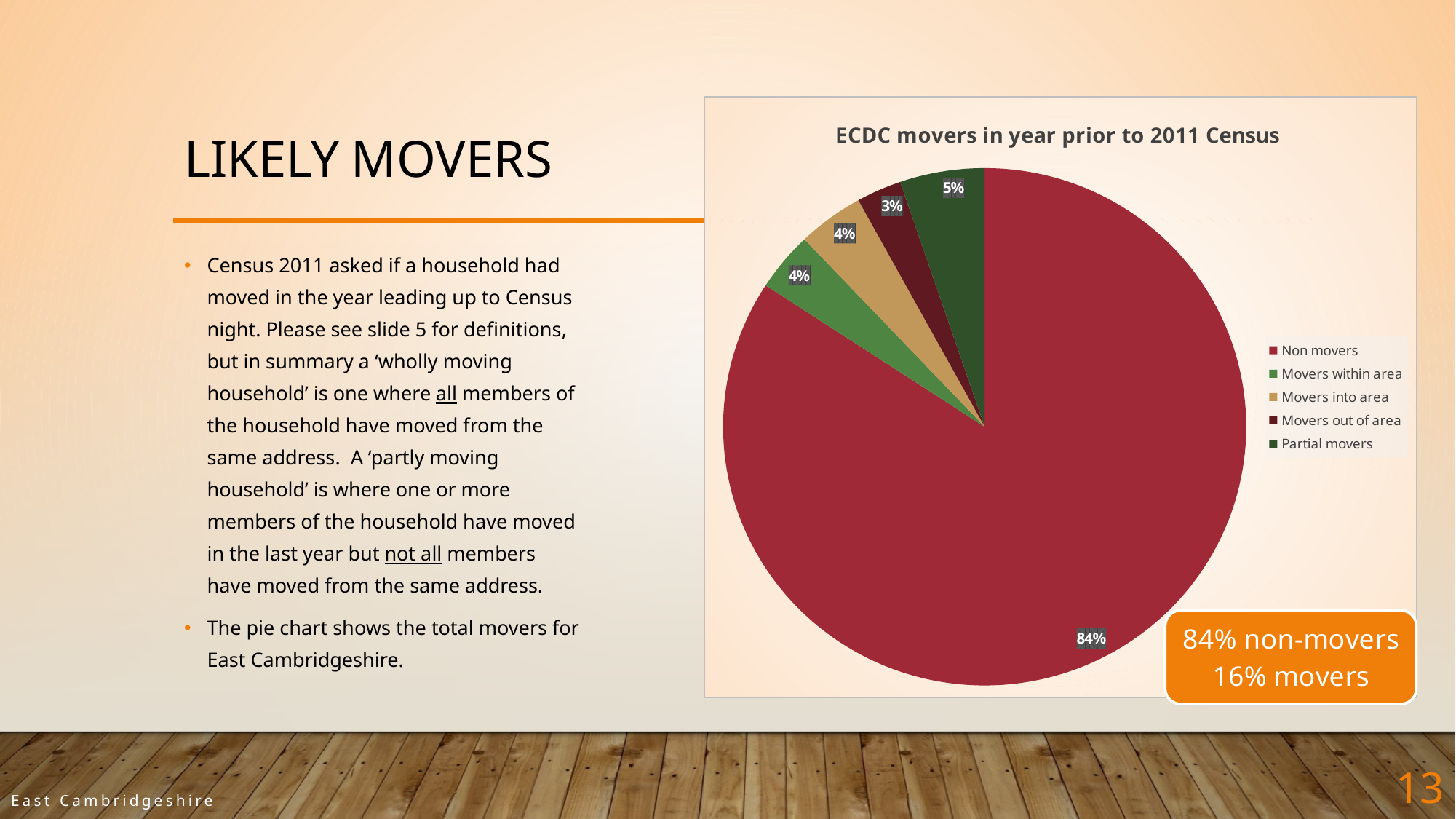
What share of the pie is Non movers? 84% How many categories does the pie chart have? 5 What is the title of the chart? ECDC movers in year prior to 2011 Census What percentage is shown for Movers into area? 4% What is the combined share of all the mover categories (Movers within area, Movers into area, Movers out of area and Partial movers)? 16% Which is larger, the Partial movers slice or the Movers out of area slice? Partial movers What percentage is shown for Movers out of area? 3% Which category has the largest slice of the pie? Non movers What is the difference between the Non movers share and the Partial movers share? 79% What type of chart is shown on the slide? pie chart Which category has the smallest slice of the pie? Movers out of area What percentage is shown for Partial movers? 5%